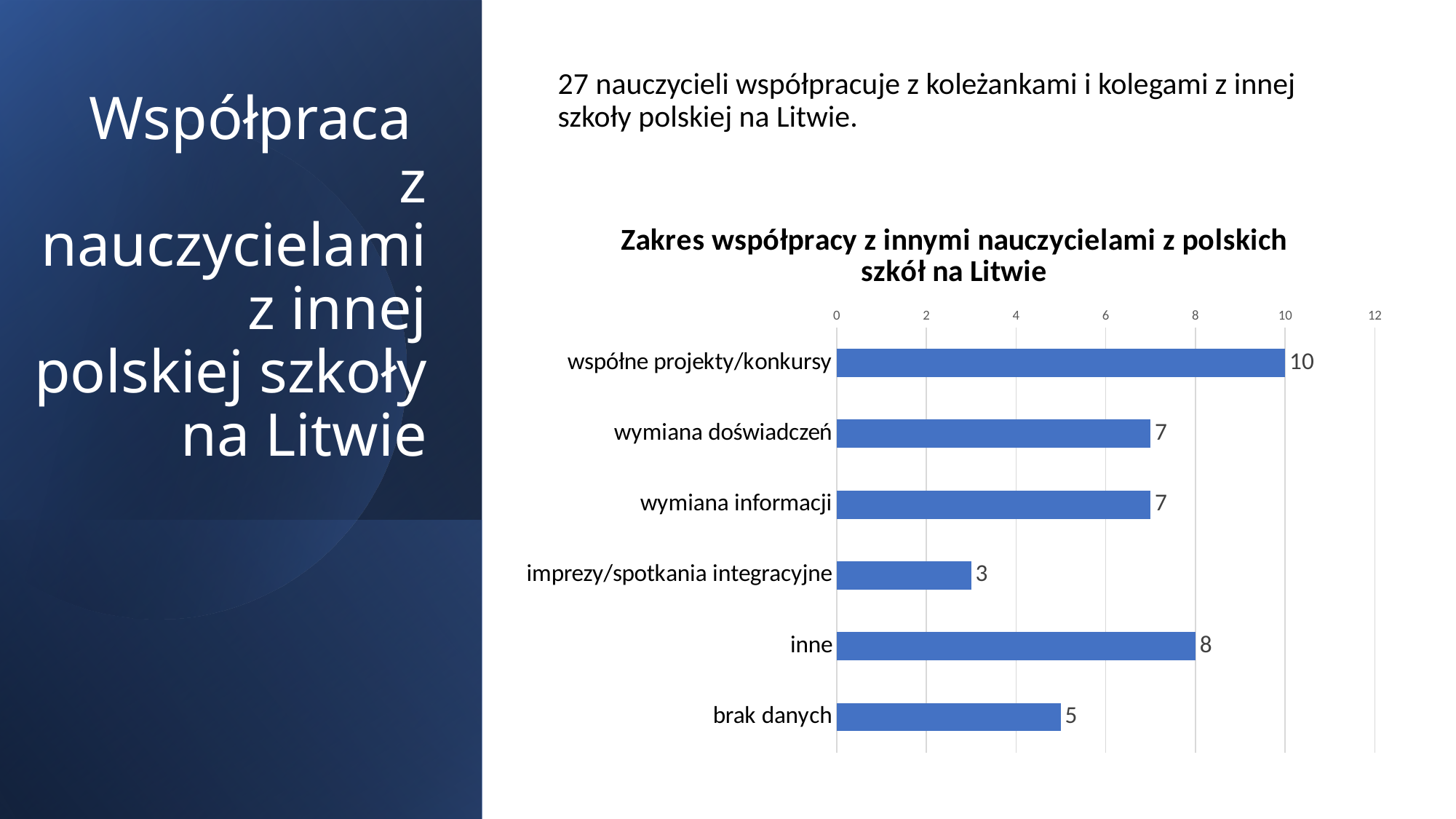
What kind of chart is shown on the slide? bar chart Which category has the highest value? wspólne projekty/konkursy What is the value for imprezy/spotkania integracyjne? 3 Which is larger, the value for inne or the value for wymiana informacji? inne How many categories are shown in the chart? 6 What is the title of the chart? Zakres współpracy z innymi nauczycielami z polskich szkół na Litwie What is the difference between the values for wspólne projekty/konkursy and inne? 2 Which category has the lowest value? imprezy/spotkania integracyjne Is the value for brak danych greater or less than 6? less What is the value for brak danych? 5 What is the value for inne? 8 What is the value for wspólne projekty/konkursy? 10